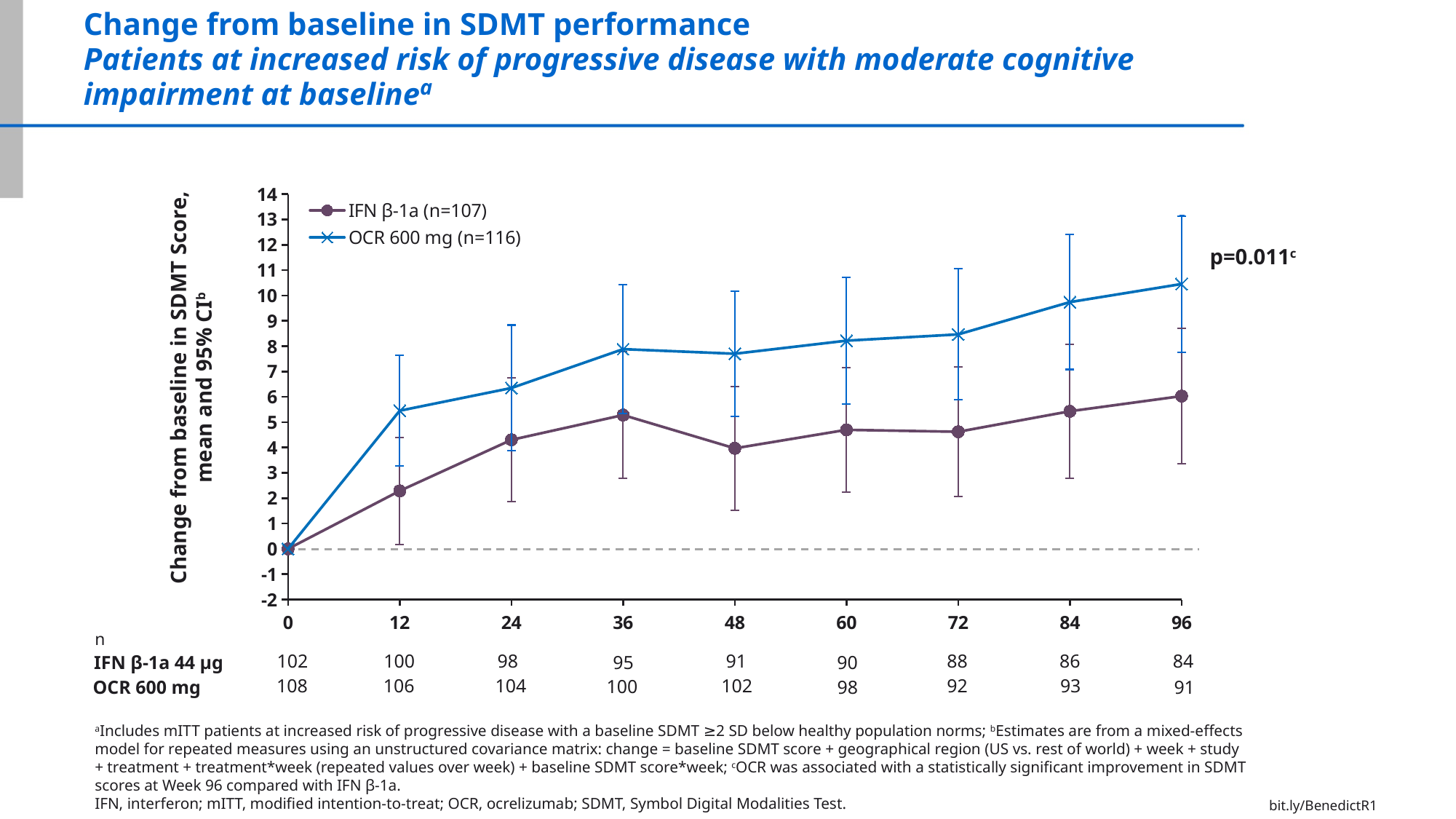
Is the value for OCR 600 mg at week 36 greater or less than 7? greater How many series does the legend list? 2 How many time points (weeks) are plotted along the x axis? 9 Which series has the higher change from baseline in SDMT score at week 96? OCR 600 mg (n=116) Is the value for IFN β-1a at week 48 greater or less than 5? less Does the OCR 600 mg series generally rise or fall from week 0 to week 96? rise Is the value for IFN β-1a at week 12 greater or less than 3? less What is the n for OCR 600 mg at week 96 in the table below the chart? 91 What p-value is shown next to the chart? p=0.011 At which week does the OCR 600 mg series reach its highest value? 96 What kind of chart is shown on the slide? line chart